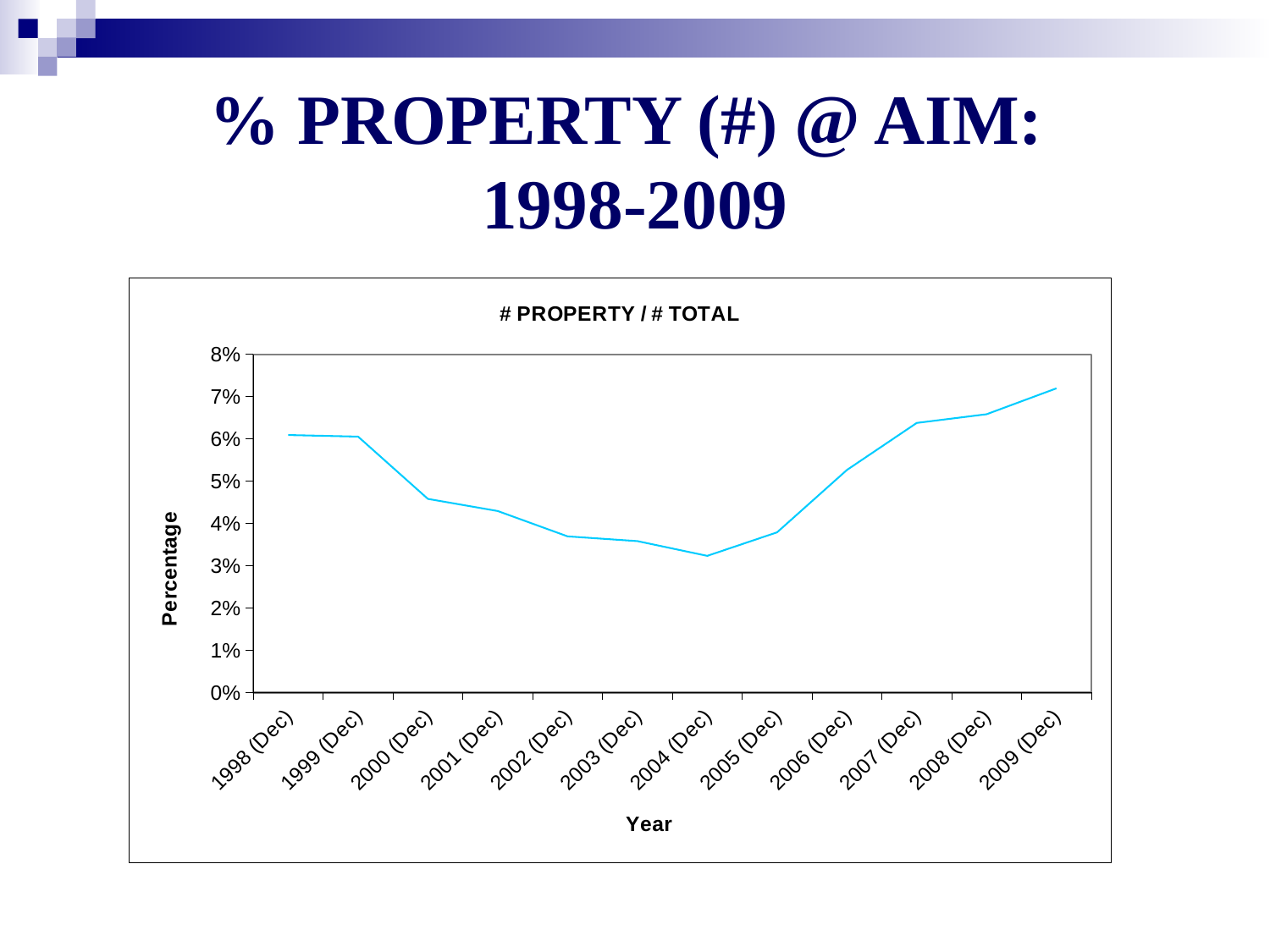
Is the value for 2009 (Dec) greater or less than 7%? greater Which year has the lowest percentage? 2004 (Dec) Is the value for 2006 (Dec) greater or less than 5%? greater What is the label of the y axis? Percentage How many years are plotted on the x axis? 12 What is the title of the chart? # PROPERTY / # TOTAL Which year has the highest percentage? 2009 (Dec) Which is larger, the value for 1998 (Dec) or the value for 2000 (Dec)? 1998 (Dec) What kind of chart is shown on the slide? line chart Does the percentage rise or fall from 2004 (Dec) to 2009 (Dec)? rise Is the value for 1998 (Dec) greater or less than 6%? greater